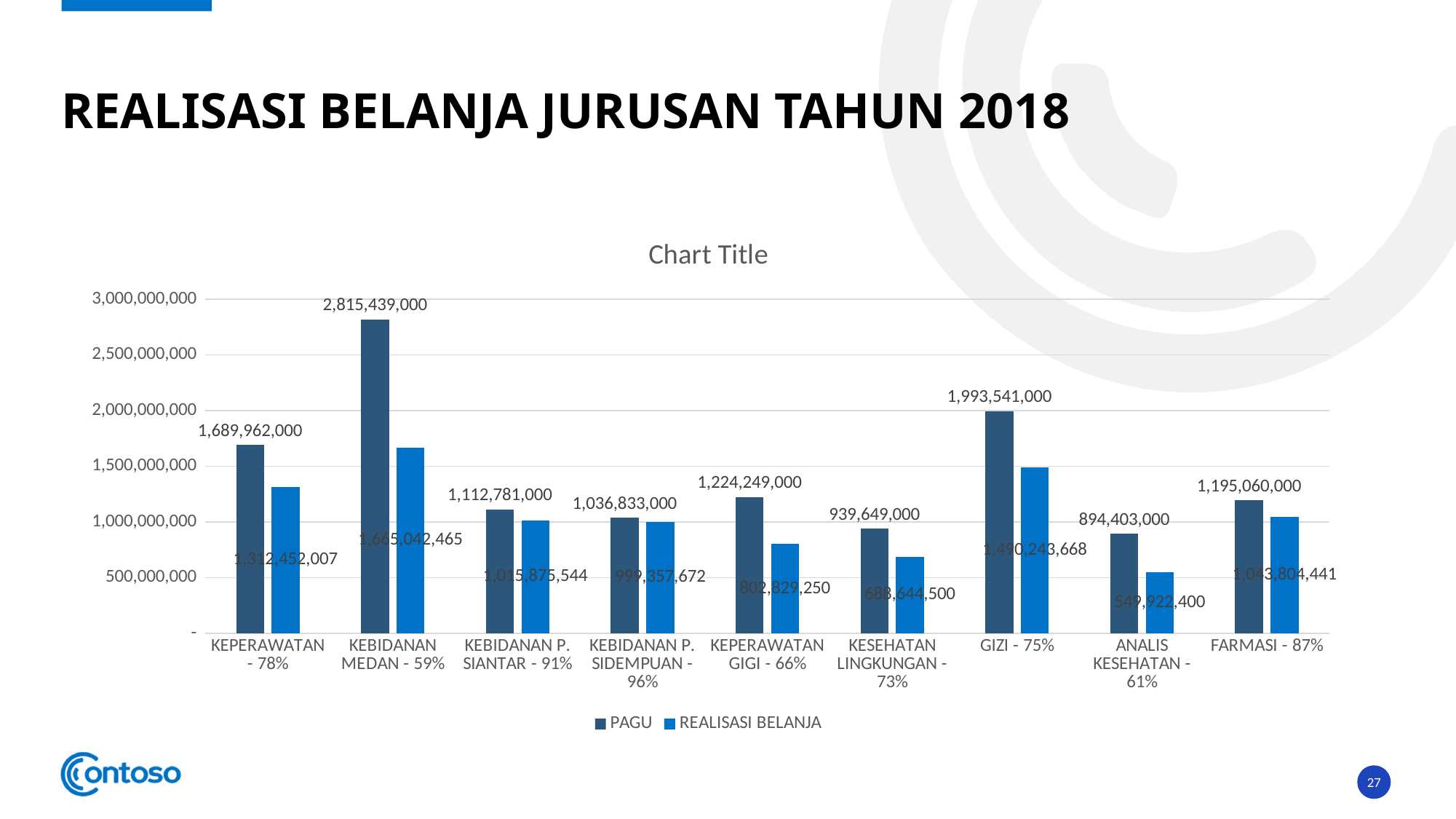
Which is larger, the PAGU value for GIZI - 75% or the PAGU value for KEPERAWATAN - 78%? GIZI - 75% What is the REALISASI BELANJA value for GIZI - 75%? 1,490,243,668 Which category has the highest PAGU value? KEBIDANAN MEDAN - 59% How many categories are shown on the x axis? 9 What kind of chart is shown on the slide? bar chart What is the PAGU value for KEBIDANAN MEDAN - 59%? 2,815,439,000 What is the REALISASI BELANJA value for KEBIDANAN P. SIDEMPUAN - 96%? 999,357,672 Is the REALISASI BELANJA value for KESEHATAN LINGKUNGAN - 73% greater or less than 1,000,000,000? less How many series does the legend list? 2 Which category has the lowest REALISASI BELANJA value? ANALIS KESEHATAN - 61% What is the difference between the PAGU and REALISASI BELANJA values for KEPERAWATAN - 78%? 377,509,993 What is the PAGU value for FARMASI - 87%? 1,195,060,000